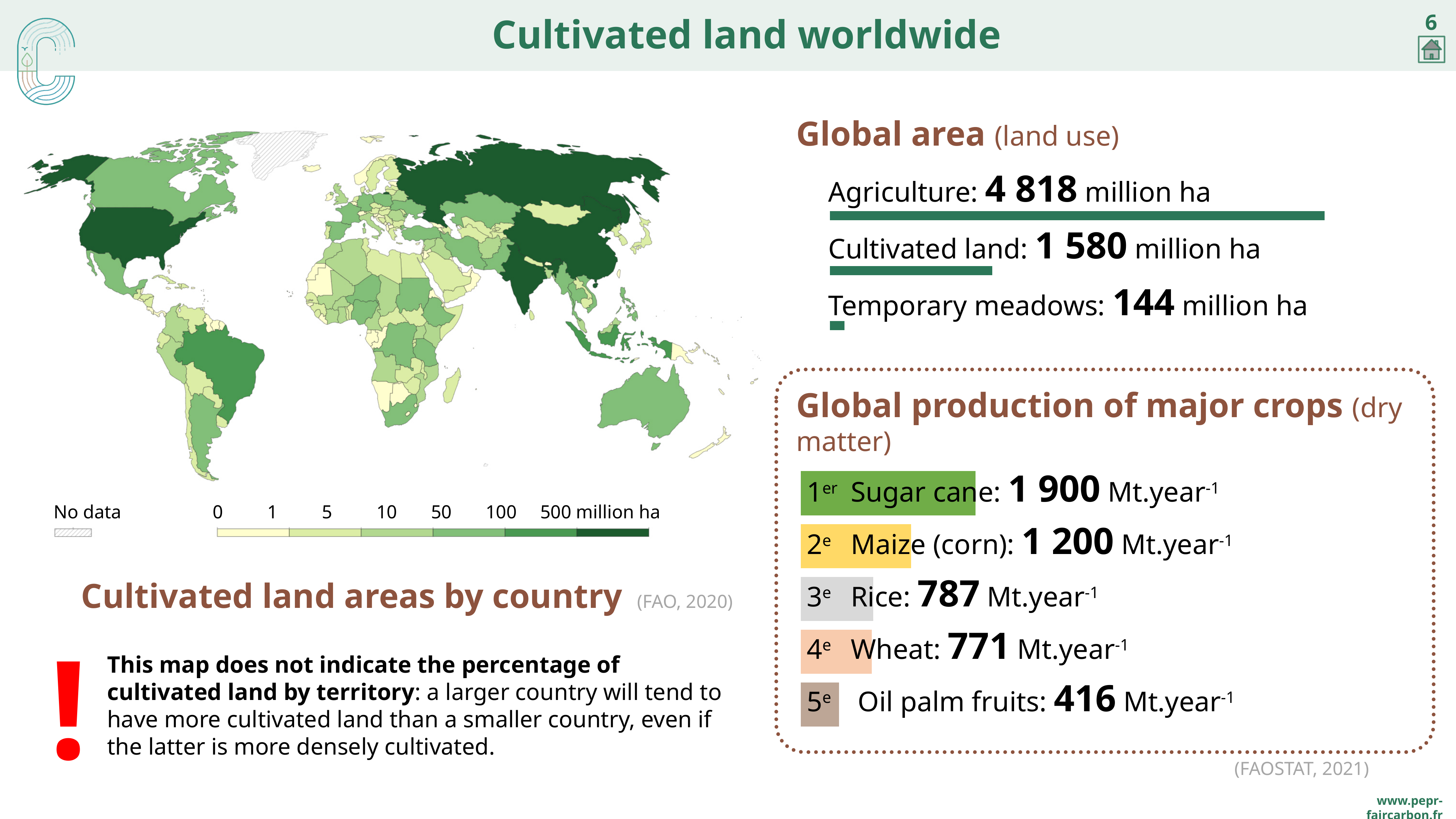
In the Global production of major crops chart, which crop has the highest production? Sugar cane In the Global production of major crops chart, what is the production of Rice? 787 Mt.year-1 In the Global area (land use) chart, what is the value for Temporary meadows? 144 million ha In the Global area (land use) chart, what is the difference between Agriculture and Cultivated land? 3 238 million ha In the Global area (land use) chart, which category has the lowest value? Temporary meadows In the Global area (land use) chart, what is the value for Cultivated land? 1 580 million ha In the Global area (land use) chart, what is the value for Agriculture? 4 818 million ha In the Global production of major crops chart, what is the production of Oil palm fruits? 416 Mt.year-1 In the Global production of major crops chart, what is the difference between Sugar cane and Maize (corn) production? 700 Mt.year-1 In the Global production of major crops chart, how many crops are listed? 5 In the Global production of major crops chart, which is larger, Rice or Wheat production? Rice In the Cultivated land areas by country map, is the value for the United States greater or less than 100 million ha? greater